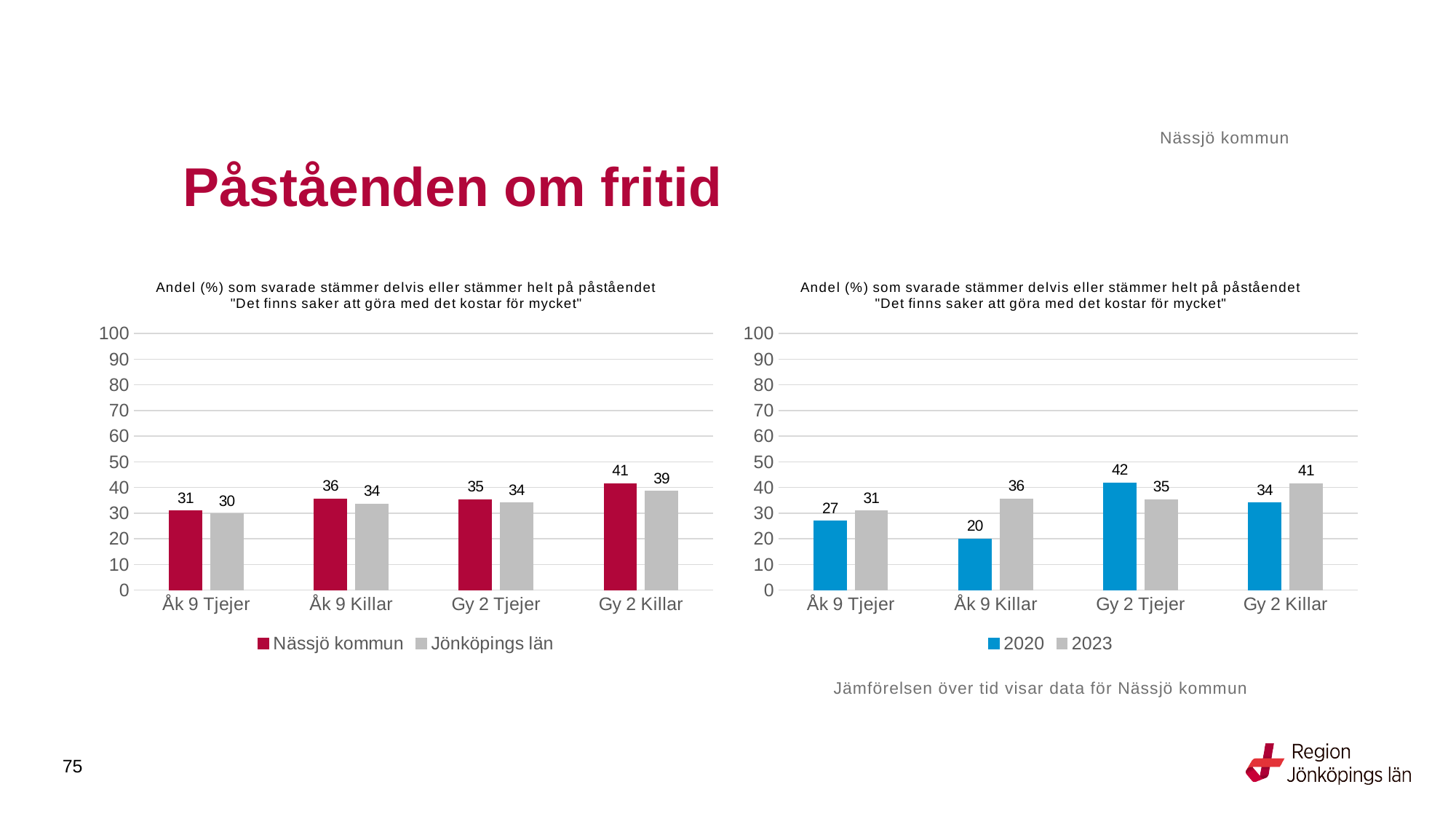
In the right chart, which is larger for Gy 2 Tjejer, the 2020 value or the 2023 value? 2020 In the right chart, how many series does the legend list? 2 In the right chart, which category has the lowest value for 2020? Åk 9 Killar In the left chart, what is the value for Jönköpings län for Åk 9 Tjejer? 30 In the right chart, what is the value for 2020 for Åk 9 Killar? 20 In the left chart, what is the value for Nässjö kommun for Gy 2 Killar? 41 In the left chart, which category has the highest value for Nässjö kommun? Gy 2 Killar In the left chart, how many categories are shown on the x axis? 4 What kind of chart is the left chart? Bar chart In the left chart, what are the two legend entries? Nässjö kommun and Jönköpings län In the right chart, what is the value for 2023 for Gy 2 Killar? 41 In the right chart, what is the difference between the 2023 and 2020 values for Åk 9 Killar? 16